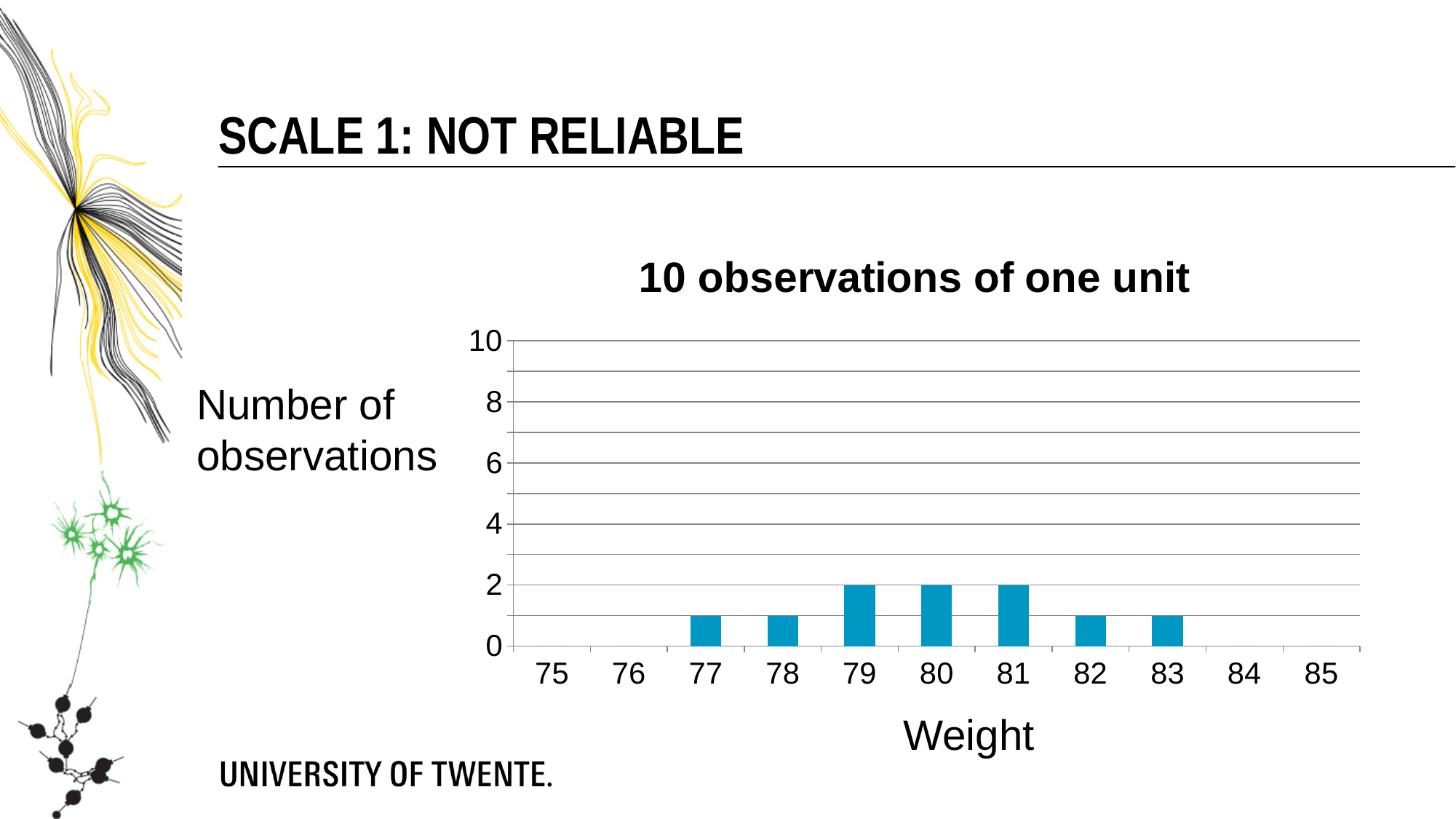
What is the title of the chart? 10 observations of one unit How many weight values are labelled on the x axis? 11 Is the number of observations for weight 80 greater or less than 4? less What is the label of the x axis of the chart? Weight What kind of chart is shown on the slide? bar chart Which has more observations, weight 79 or weight 77? 79 Is the number of observations for weight 77 greater or less than 2? less What is the number of observations for weight 79? 2 What is the number of observations for weight 80? 2 Which has more observations, weight 82 or weight 81? 81 How many weight values have a bar in the chart? 7 What is the number of observations for weight 81? 2